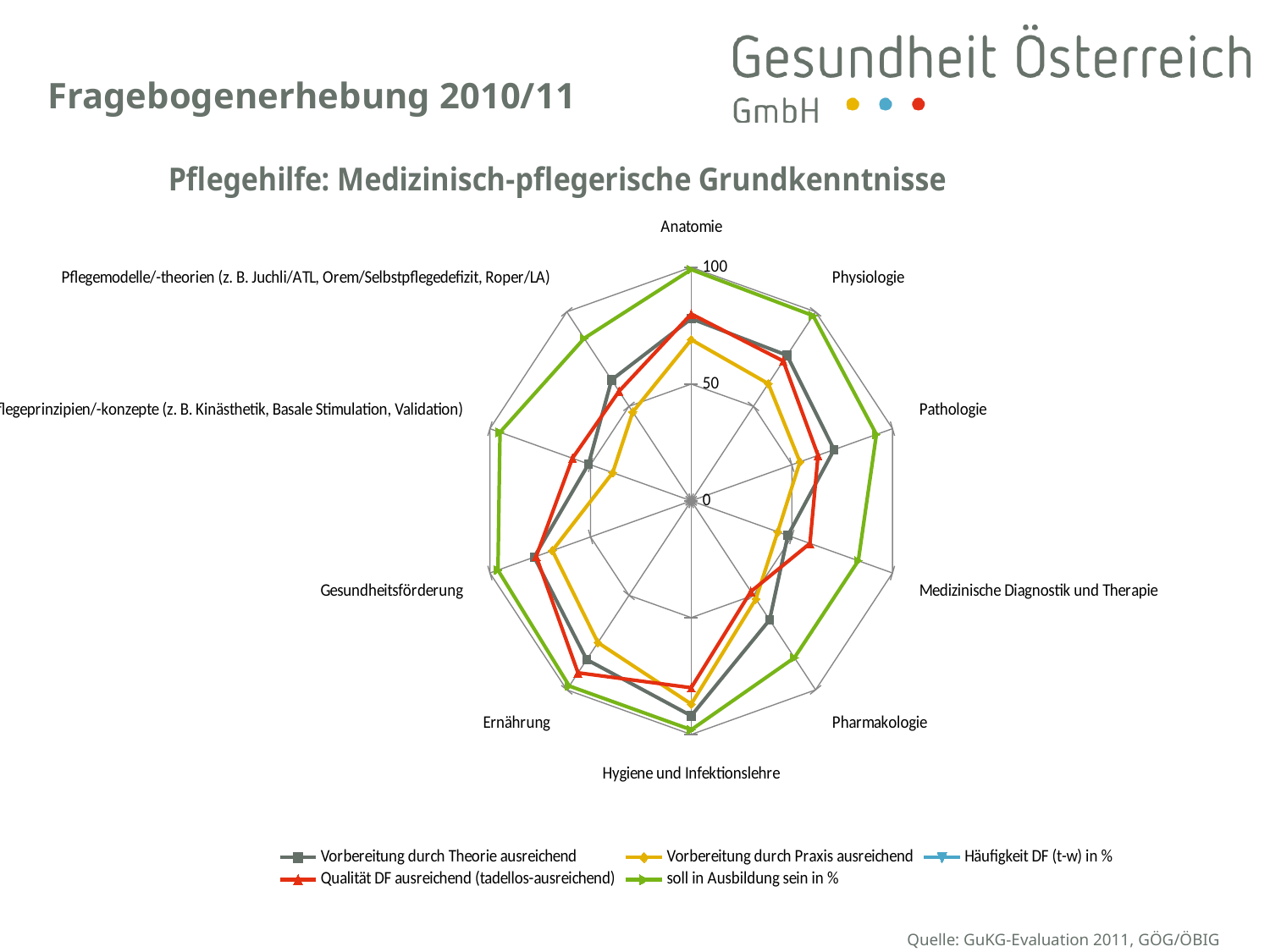
Is the value of "soll in Ausbildung sein in %" for Gesundheitsförderung greater or less than 50? greater Which series is drawn in green? soll in Ausbildung sein in % Is the value of "Vorbereitung durch Theorie ausreichend" for Hygiene und Infektionslehre greater or less than 50? greater How many series does the legend list? 5 Is the value of "Vorbereitung durch Praxis ausreichend" for Pflegeprinzipien/-konzepte greater or less than 50? less How many categories (axes) does the radar chart have? 10 What is the title of the chart? Pflegehilfe: Medizinisch-pflegerische Grundkenntnisse For which category does "Vorbereitung durch Theorie ausreichend" reach its highest value? Hygiene und Infektionslehre For Anatomie, which is larger: "soll in Ausbildung sein in %" or "Vorbereitung durch Praxis ausreichend"? soll in Ausbildung sein in % What kind of chart is shown on the slide? Radar chart For Pathologie, which is larger: "soll in Ausbildung sein in %" or "Vorbereitung durch Theorie ausreichend"? soll in Ausbildung sein in %